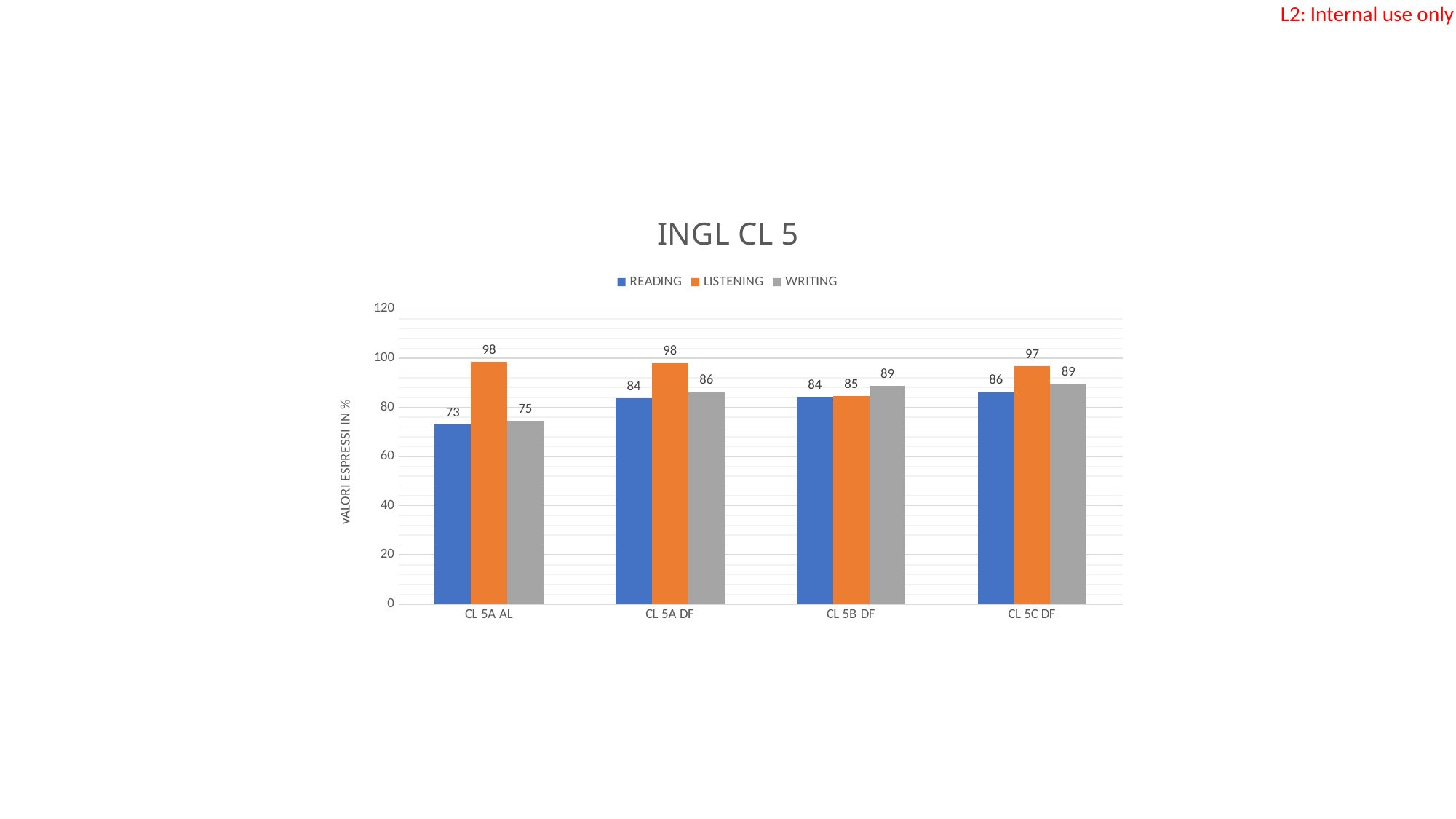
Which category has the lowest READING value? CL 5A AL Which is larger for CL 5A DF: LISTENING or WRITING? LISTENING How many series does the legend list? 3 What kind of chart is shown? Bar chart What is the title of the chart? INGL CL 5 Which category has the highest WRITING value? CL 5B DF and CL 5C DF (both 89) What is the LISTENING value for CL 5C DF? 97 What is the WRITING value for CL 5B DF? 89 What is the y-axis label of the chart? vALORI ESPRESSI IN % How many categories are shown on the x axis? 4 What is the difference between the LISTENING and READING values for CL 5A AL? 25 What is the READING value for CL 5A AL? 73